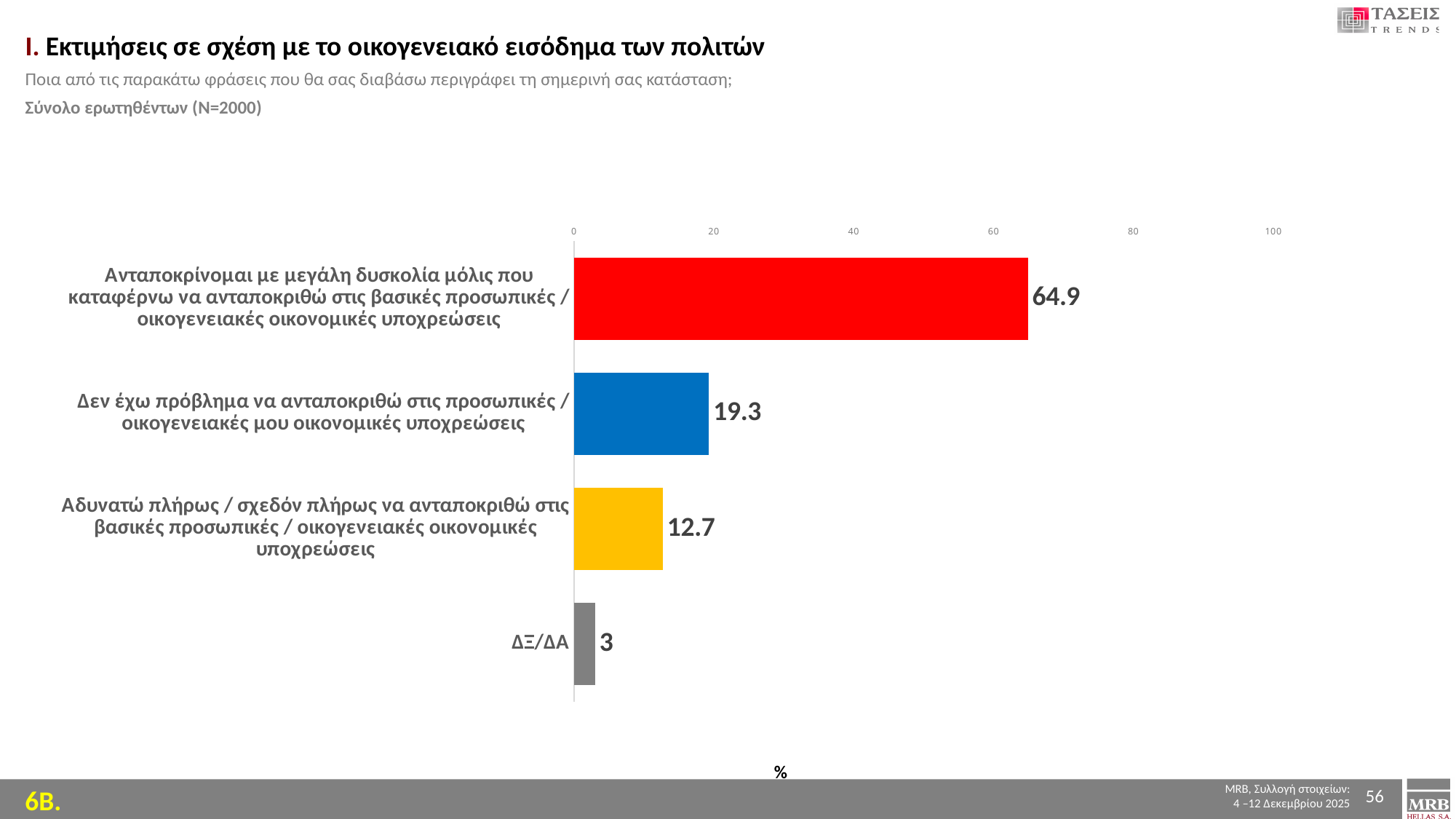
What is the value for ΔΞ/ΔΑ? 3 Which is larger: the value for 'Δεν έχω πρόβλημα να ανταποκριθώ...' or the value for 'Αδυνατώ πλήρως / σχεδόν πλήρως να ανταποκριθώ...'? Δεν έχω πρόβλημα να ανταποκριθώ στις προσωπικές / οικογενειακές μου οικονομικές υποχρεώσεις What is the difference between the highest value and the value for ΔΞ/ΔΑ? 61.9 What is the value for the category 'Ανταποκρίνομαι με μεγάλη δυσκολία μόλις που καταφέρνω να ανταποκριθώ στις βασικές προσωπικές / οικογενειακές οικονομικές υποχρεώσεις'? 64.9 What is the difference between the value for 'Δεν έχω πρόβλημα να ανταποκριθώ...' and the value for 'Αδυνατώ πλήρως / σχεδόν πλήρως να ανταποκριθώ...'? 6.6 How many categories are shown in the chart? 4 What is the value for 'Δεν έχω πρόβλημα να ανταποκριθώ στις προσωπικές / οικογενειακές μου οικονομικές υποχρεώσεις'? 19.3 Which category has the lowest value? ΔΞ/ΔΑ What kind of chart is shown on the slide? bar chart Is the value for 'Ανταποκρίνομαι με μεγάλη δυσκολία...' greater or less than 60? greater What is the value for 'Αδυνατώ πλήρως / σχεδόν πλήρως να ανταποκριθώ στις βασικές προσωπικές / οικογενειακές οικονομικές υποχρεώσεις'? 12.7 Which category has the highest value? Ανταποκρίνομαι με μεγάλη δυσκολία μόλις που καταφέρνω να ανταποκριθώ στις βασικές προσωπικές / οικογενειακές οικονομικές υποχρεώσεις